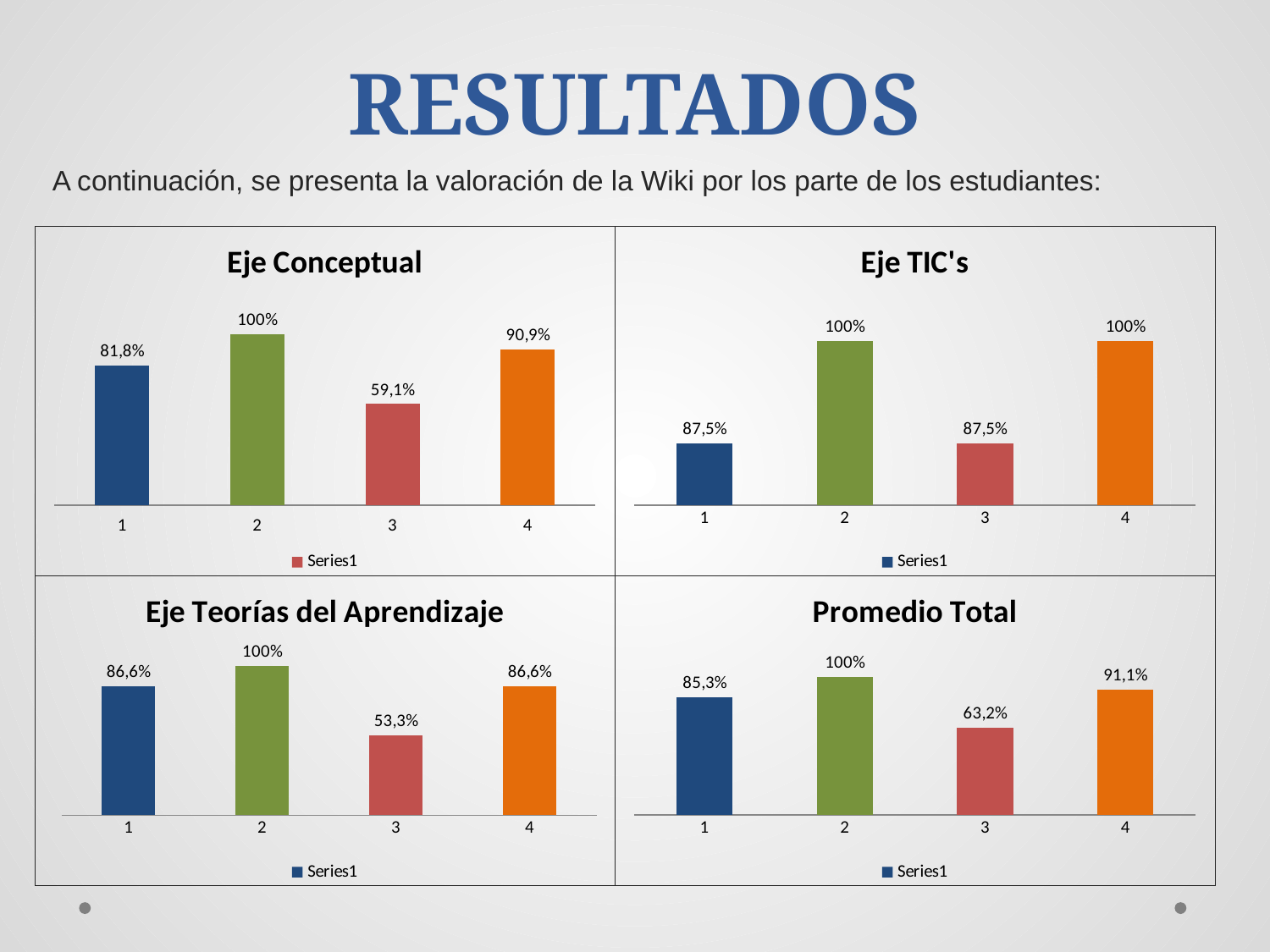
In the Promedio Total chart, which category has the lowest value? 3 In the Promedio Total chart, what is the value for category 3? 63,2% In the Promedio Total chart, what is the difference between the values for category 4 and category 1? 5,8 percentage points In the Eje Teorías del Aprendizaje chart, which category has the lowest value? 3 In the Eje Conceptual chart, what is the difference between the values for category 2 and category 3? 40,9 percentage points In the Eje Conceptual chart, which is larger: the value for category 1 or the value for category 4? Category 4 What kind of chart is the Promedio Total chart? Bar chart In the Eje Conceptual chart, what is the value for category 3? 59,1% In the Eje TIC's chart, what is the value for category 1? 87,5% In the Eje Teorías del Aprendizaje chart, what is the value for category 4? 86,6% In the Eje Conceptual chart, which category has the highest value? 2 How many categories are shown in the Eje TIC's chart? 4